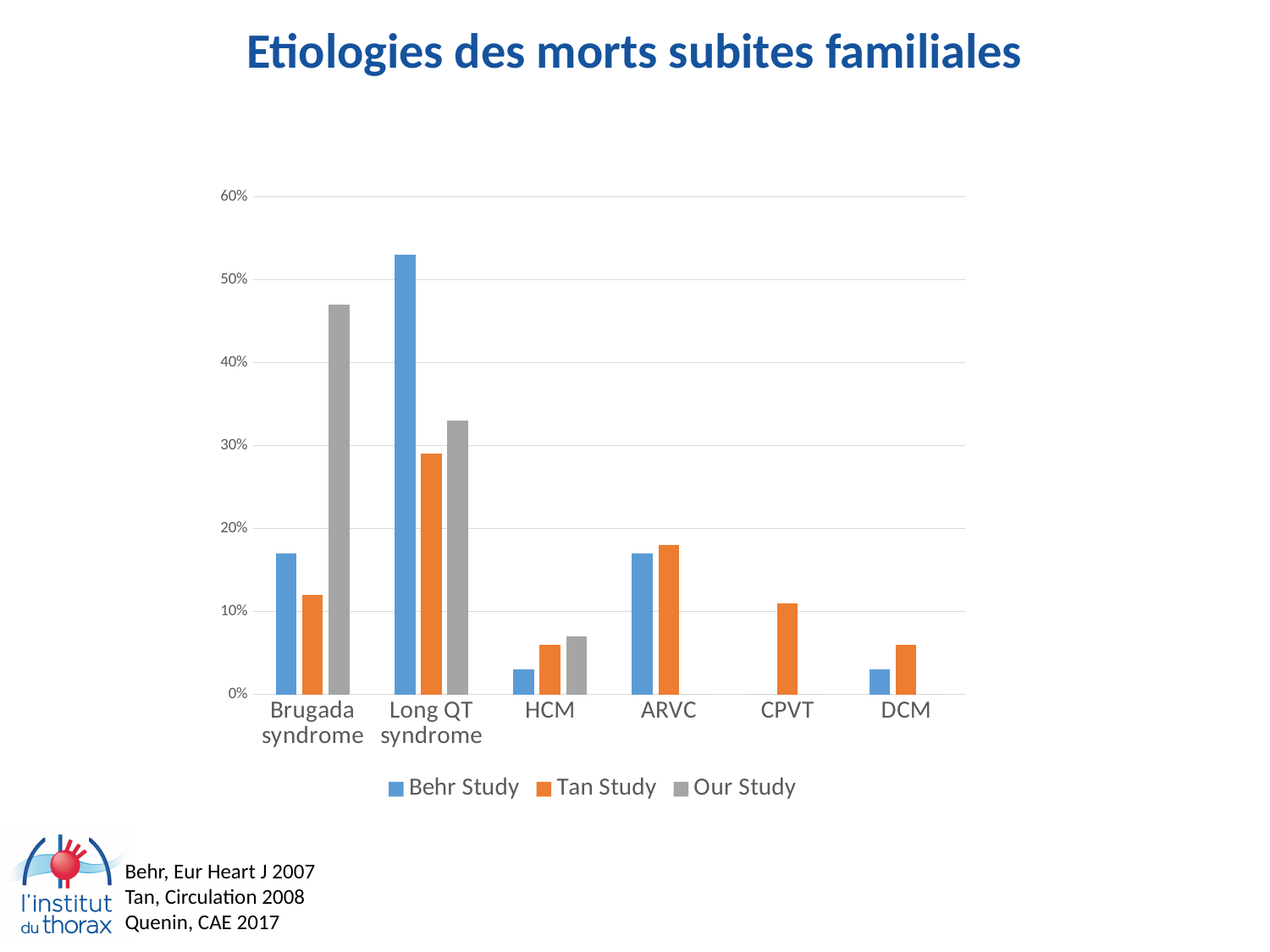
Is the Behr Study value for Long QT syndrome greater or less than 50%? greater What is the title of the chart? Etiologies des morts subites familiales Which category has the tallest bar in the chart? Long QT syndrome Is the Behr Study value for Brugada syndrome greater or less than 20%? less Is the Tan Study value for Long QT syndrome greater or less than 20%? greater What kind of chart is shown on the slide? bar chart How many categories are shown on the x axis? 6 For Long QT syndrome, which is larger: the Behr Study value or the Our Study value? Behr Study For the Our Study series, which category has the highest value? Brugada syndrome For Brugada syndrome, which is larger: the Behr Study value or the Tan Study value? Behr Study How many series does the legend list? 3